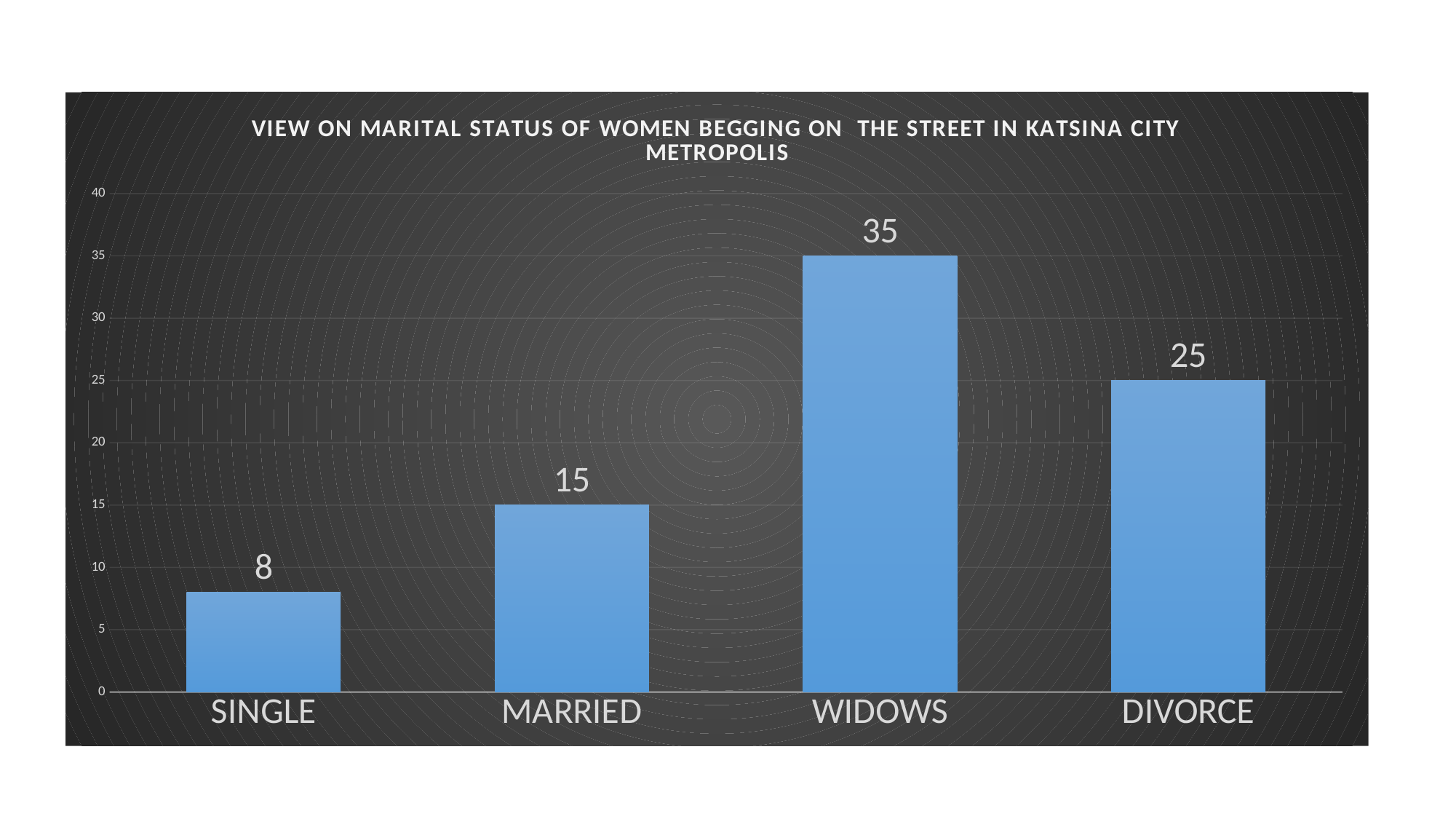
What is the difference between the values for WIDOWS and DIVORCE? 10 What is the value for DIVORCE? 25 What is the title of the chart? VIEW ON MARITAL STATUS OF WOMEN BEGGING ON THE STREET IN KATSINA CITY METROPOLIS What is the difference between the values for MARRIED and SINGLE? 7 What kind of chart is shown on the slide? Bar chart What is the value for WIDOWS? 35 What is the value for MARRIED? 15 Which category has the highest value? WIDOWS What is the value for SINGLE? 8 How many categories are shown on the x axis? 4 Which is larger, the value for DIVORCE or the value for MARRIED? DIVORCE Which category has the lowest value? SINGLE